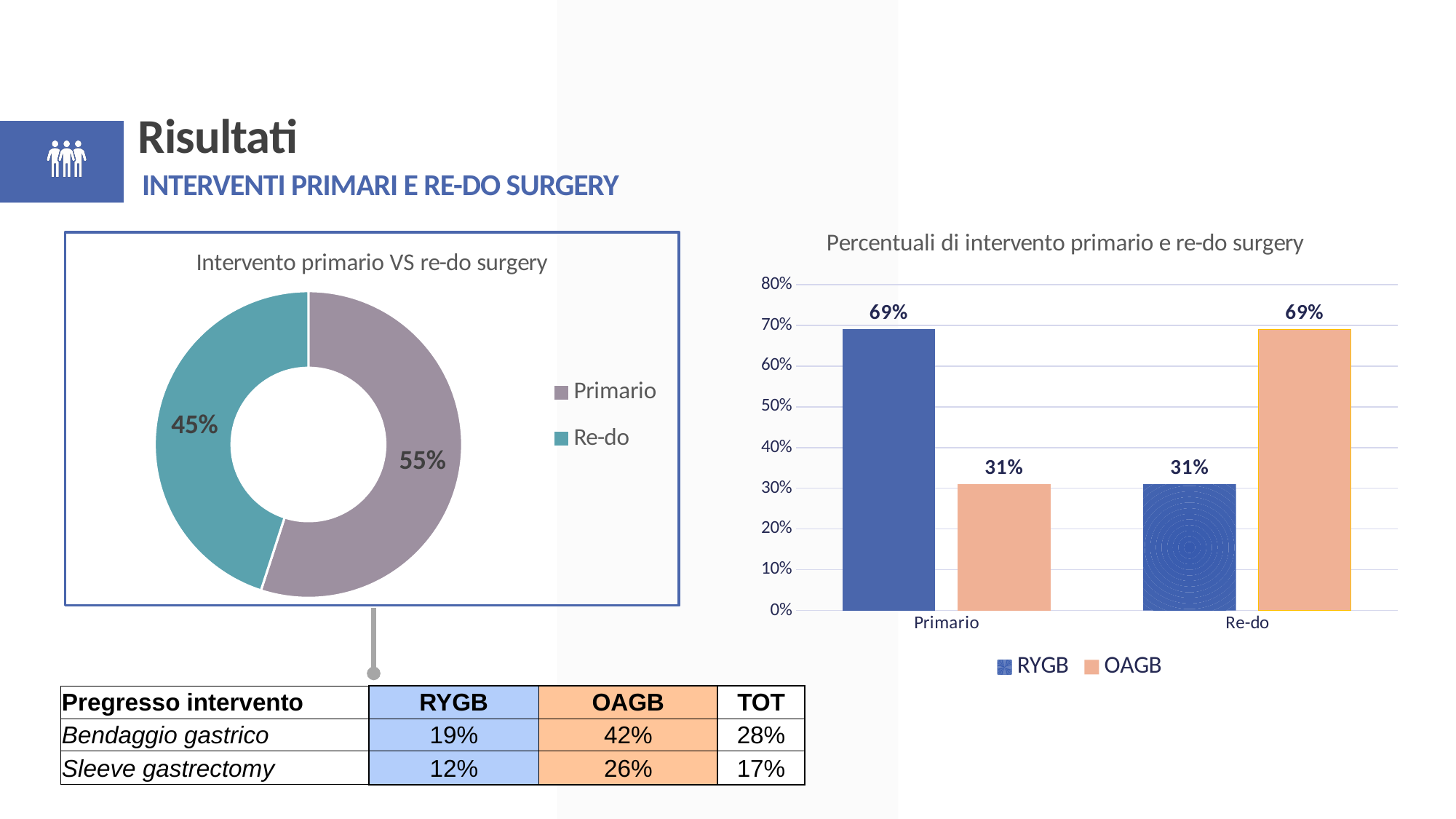
In the chart titled "Percentuali di intervento primario e re-do surgery", what is the value for RYGB in the Primario category? 69% In the chart titled "Percentuali di intervento primario e re-do surgery", is the value for OAGB in the Primario category greater or less than 40%? less In the chart titled "Percentuali di intervento primario e re-do surgery", which series is larger in the Re-do category, RYGB or OAGB? OAGB In the chart titled "Intervento primario VS re-do surgery", which slice is larger, Primario or Re-do? Primario In the chart titled "Intervento primario VS re-do surgery", what share does Primario have? 55% How many series does the legend of the chart titled "Percentuali di intervento primario e re-do surgery" list? 2 In the chart titled "Percentuali di intervento primario e re-do surgery", what is the value for OAGB in the Re-do category? 69% In the chart titled "Percentuali di intervento primario e re-do surgery", what is the difference between RYGB and OAGB in the Primario category? 38% What kind of chart is the one titled "Percentuali di intervento primario e re-do surgery"? Bar chart How many slices does the chart titled "Intervento primario VS re-do surgery" have? 2 In the chart titled "Intervento primario VS re-do surgery", what share does Re-do have? 45% What kind of chart is the one titled "Intervento primario VS re-do surgery"? Doughnut chart